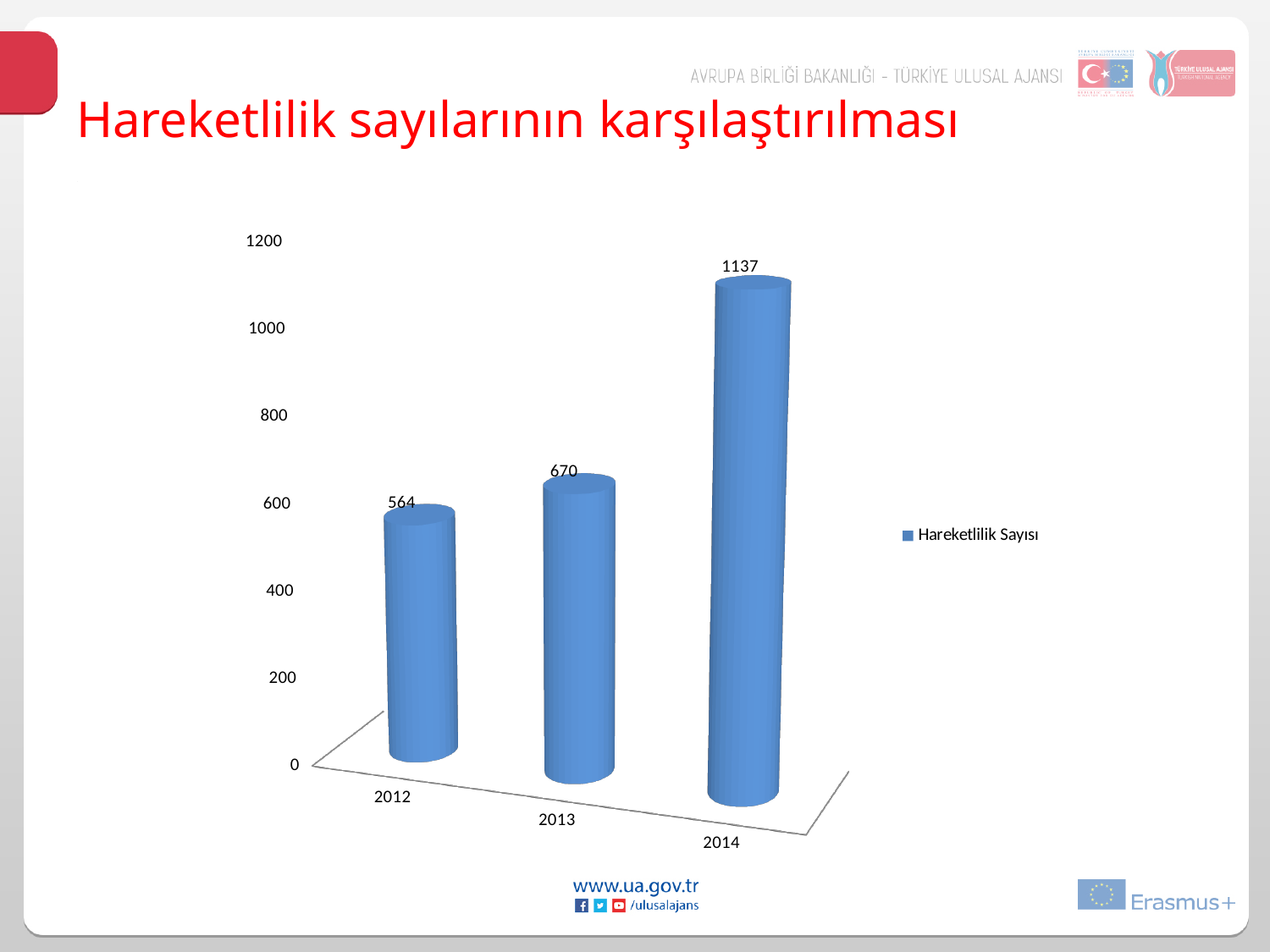
What is the name of the series listed in the legend? Hareketlilik Sayısı Is the value for 2014 greater or less than 1000? greater What is the value for 2013? 670 What is the value for 2012? 564 Which is larger, the value for 2012 or the value for 2013? 2013 What is the value for 2014? 1137 Which year has the highest value? 2014 Which year has the lowest value? 2012 How many years are shown on the x axis? 3 What is the difference between the values for 2014 and 2013? 467 What kind of chart is shown on the slide? bar chart What is the difference between the values for 2013 and 2012? 106